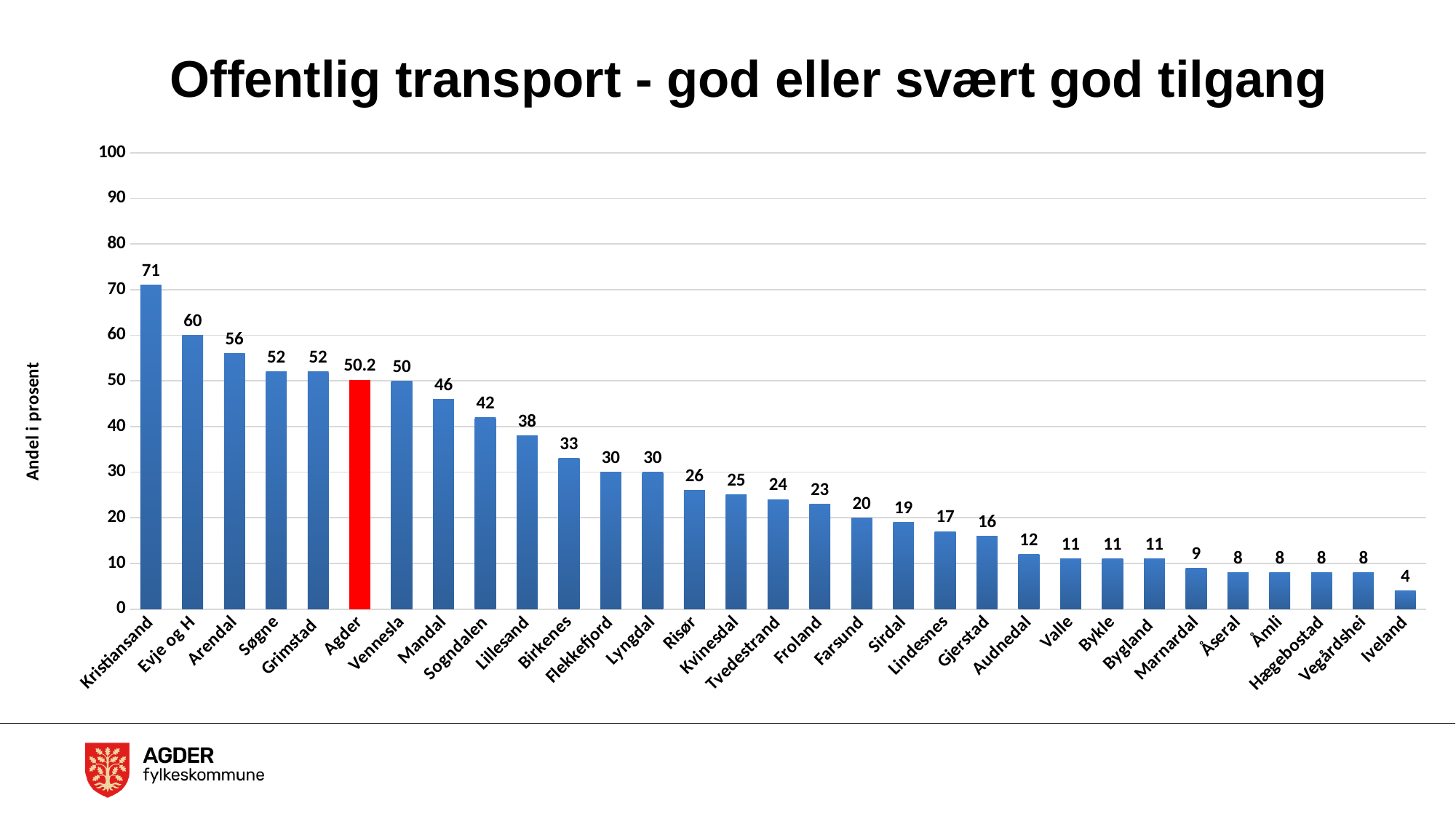
What kind of chart is this? Bar chart Do the values rise or fall from left to right along the x axis? Fall Which is larger, the value for Birkenes or the value for Froland? Birkenes What is the value for Lillesand? 38 Which category has the highest value? Kristiansand What is the difference between the values for Kristiansand and Evje og H? 11 How many categories are shown on the x axis? 31 What is the value for Kristiansand? 71 What is the value for Agder? 50.2 Which bar is coloured red? Agder Which category has the lowest value? Iveland What is the difference between the values for Mandal and Risør? 20